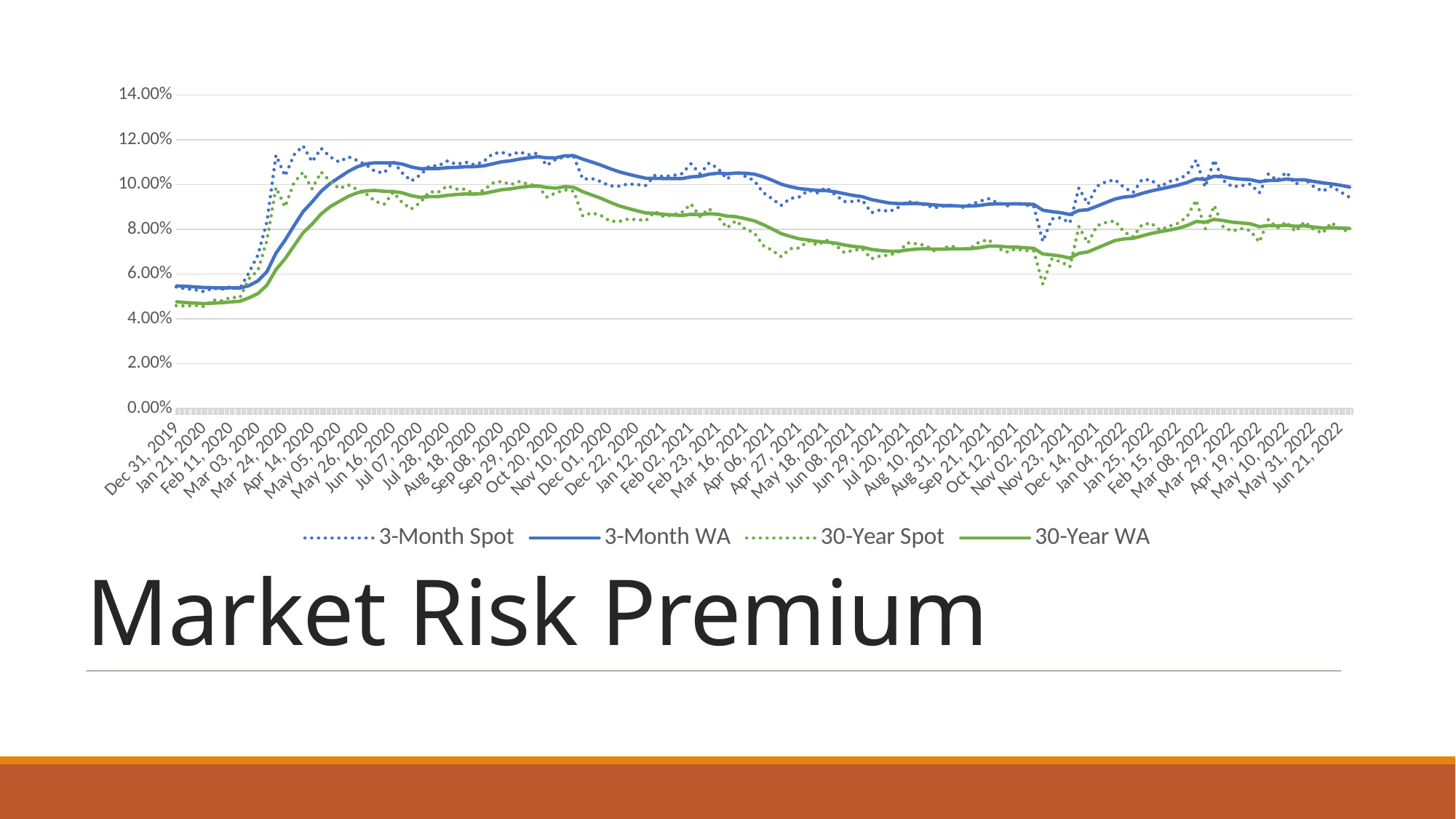
Is the value of 30-Year WA at Aug 10, 2021 greater or less than 8.00%? less What kind of chart is shown on the slide? line chart Does the 3-Month WA series rise or fall between Dec 31, 2019 and Apr 14, 2020? rise At Nov 10, 2020, which is higher: 3-Month WA or 30-Year WA? 3-Month WA Is the value of 3-Month WA at Jun 21, 2022 greater or less than 12.00%? less Which two series are drawn with dotted lines? 3-Month Spot and 30-Year Spot Is the value of 3-Month WA at Dec 31, 2019 greater or less than 4.00%? greater Does the 30-Year WA series rise or fall between Nov 10, 2020 and Aug 10, 2021? fall How many series does the legend list? 4 What is the title of the slide containing the chart? Market Risk Premium